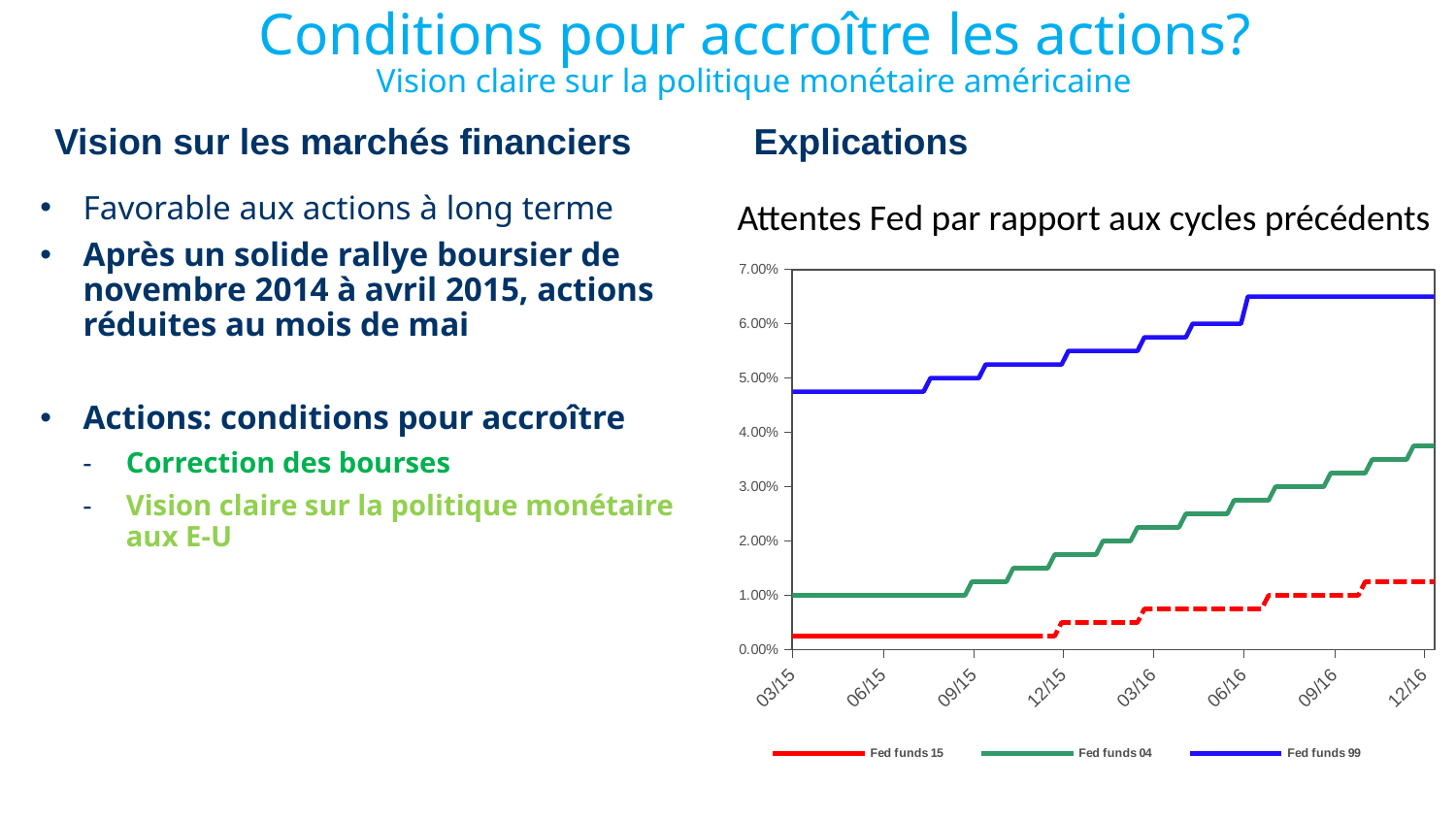
How many series does the chart's legend list? 3 Which series has the highest values across the whole chart? Fed funds 99 What is the title of the chart on the slide? Attentes Fed par rapport aux cycles précédents Is the value for Fed funds 99 at 12/16 greater or less than 6.00%? greater At 12/16, which is larger: Fed funds 99 or Fed funds 15? Fed funds 99 Is the value for Fed funds 15 at 12/16 greater or less than 2.00%? less What kind of chart is shown on the slide? line chart What colour is the Fed funds 15 line in the chart? red Which series has the lowest values across the whole chart? Fed funds 15 Does the Fed funds 99 line rise or fall from 03/15 to 12/16? rise Is the value for Fed funds 04 at 03/15 greater or less than 2.00%? less Does the Fed funds 04 line rise or fall from 03/15 to 12/16? rise